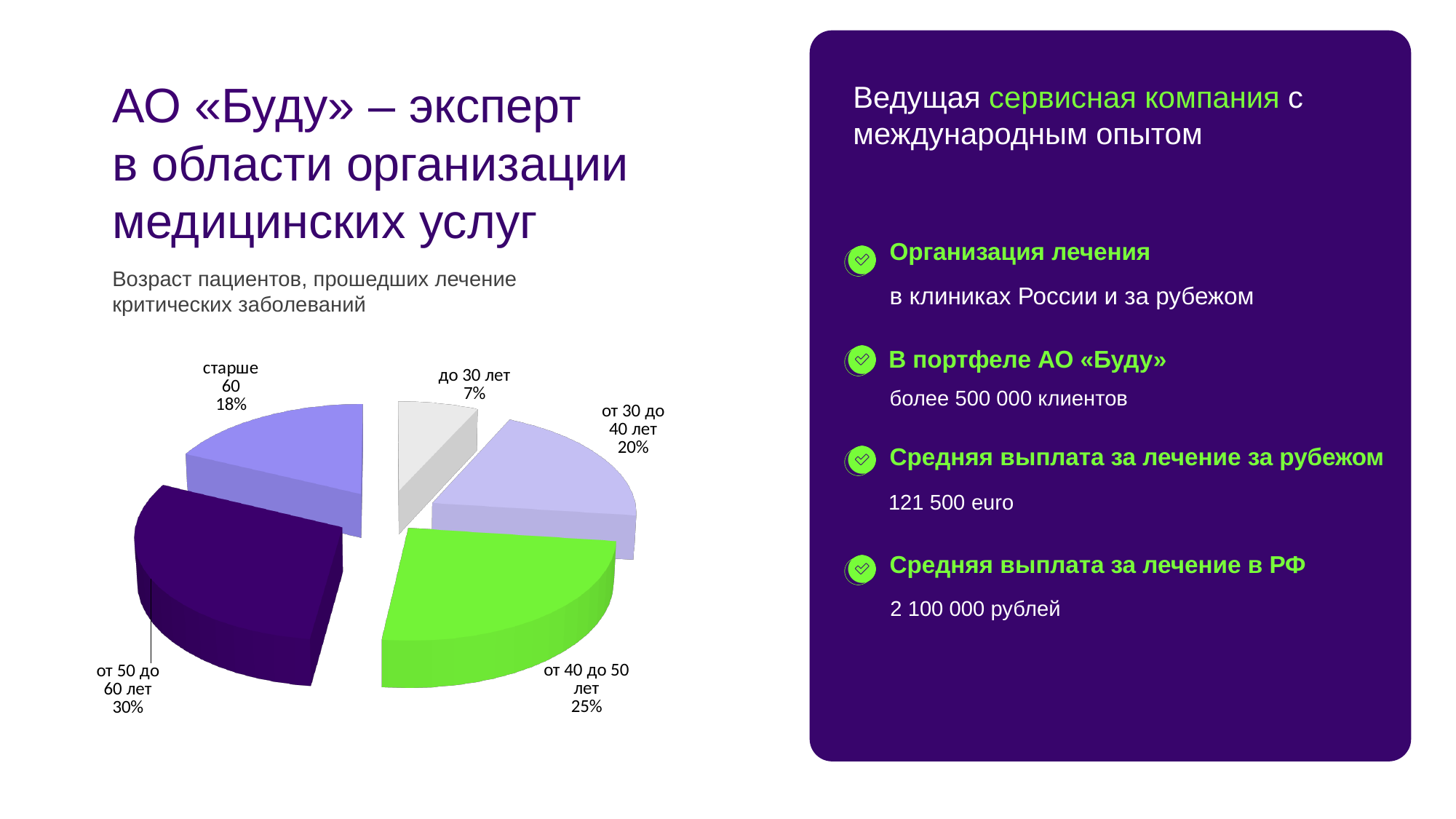
What share of patients are aged "до 30 лет"? 7% What colour is the slice for "от 40 до 50 лет"? Green Which age group has the largest share of patients? от 50 до 60 лет What is the title of the chart? Возраст пациентов, прошедших лечение критических заболеваний What share of patients are aged "от 50 до 60 лет"? 30% What type of chart is shown on the slide? Pie chart What share of patients are aged "старше 60"? 18% What share of patients are aged "от 30 до 40 лет"? 20% Which age group has the smallest share of patients? до 30 лет What is the difference in percentage points between the "от 40 до 50 лет" and "от 30 до 40 лет" groups? 5 Which group has a larger share: "старше 60" or "от 30 до 40 лет"? от 30 до 40 лет How many age groups are shown in the pie chart? 5